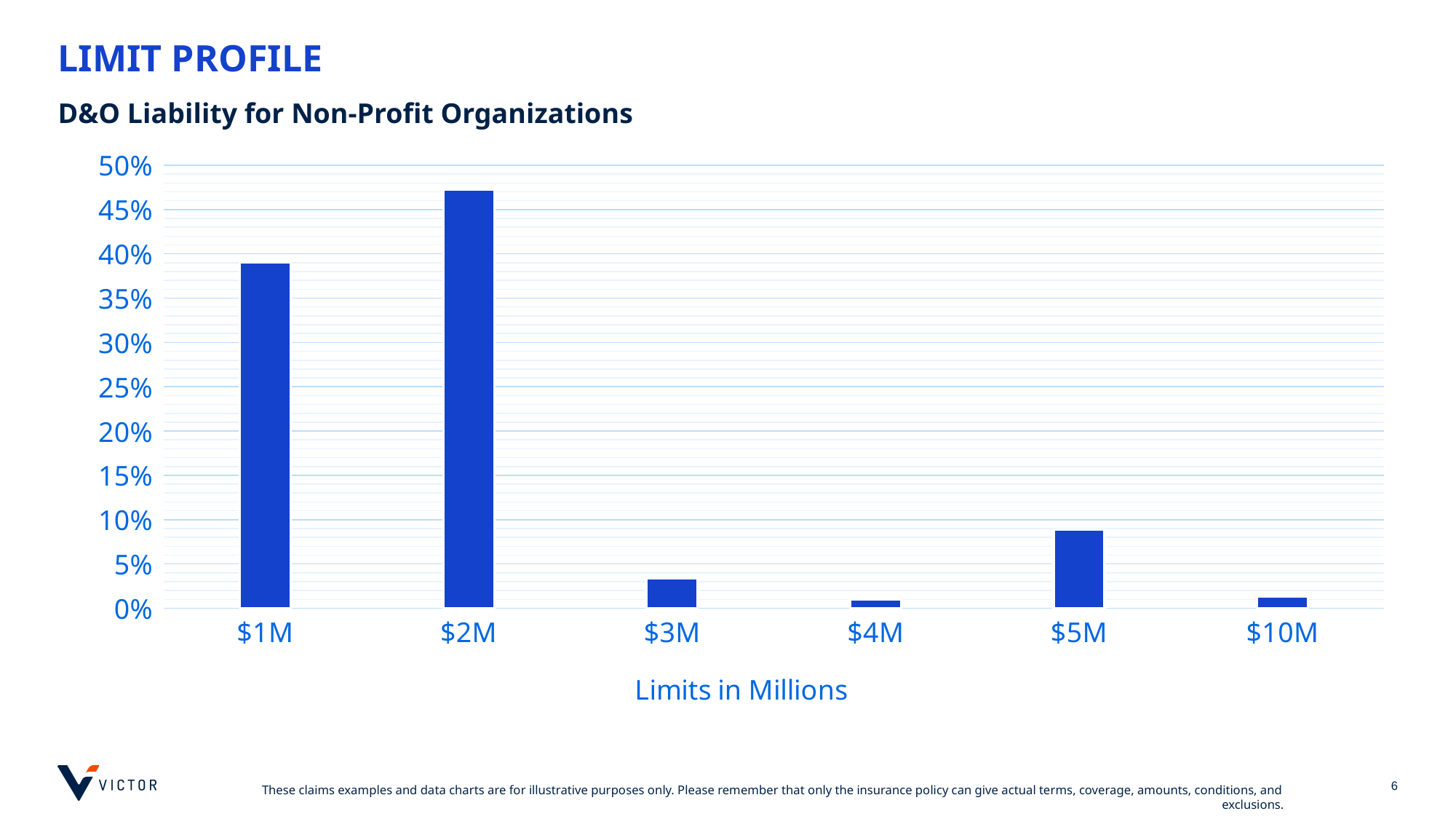
Which limit has the highest percentage? $2M Is the value for $5M greater or less than 10%? less Is the value for $3M greater or less than 5%? less What kind of chart is shown on the slide? bar chart Is the value for $1M greater or less than 35%? greater What is the maximum value shown on the y axis? 50% What is the x-axis title of the chart? Limits in Millions How many limit categories are shown on the x axis? 6 Which is larger, the value for $1M or the value for $2M? $2M Which is larger, the value for $3M or the value for $5M? $5M